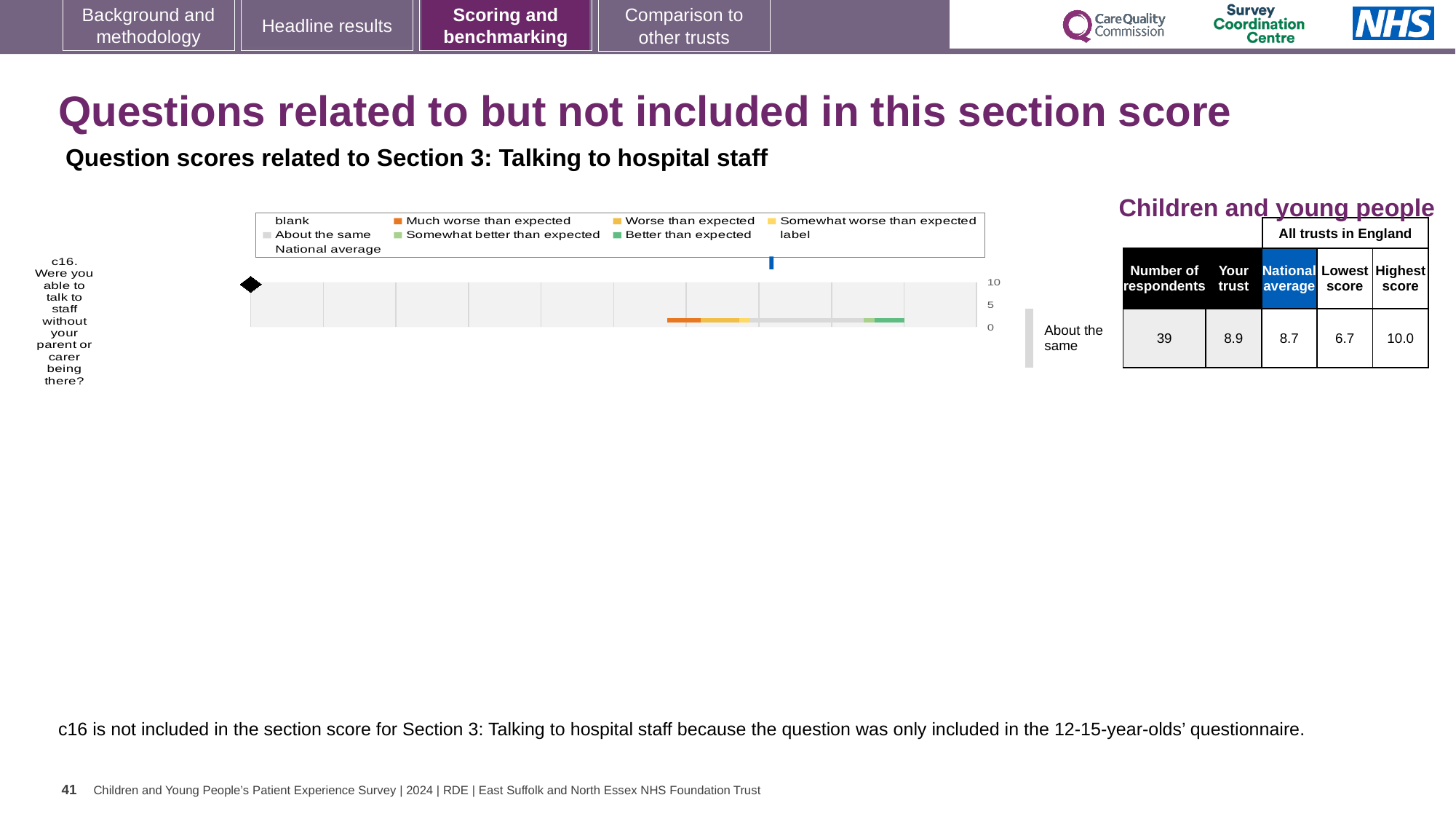
What is the highest score among all trusts in England for c16? 10.0 By how much does the 'Your trust' score for c16 exceed the national average? 0.2 What is the national average score for c16? 8.7 What is the 'Your trust' score for c16? 8.9 What is the lowest score among all trusts in England for c16? 6.7 What is the full wording of question c16 shown on the chart's axis? Were you able to talk to staff without your parent or carer being there? Which benchmark category is the c16 result placed in, according to the label next to the chart? About the same What is the difference between the highest and lowest scores for c16 across all trusts in England? 3.3 How many survey questions are plotted in the chart? 1 How many respondents answered question c16? 39 What kind of chart is shown for question c16? bar chart Which is higher for c16: the 'Your trust' score or the national average? Your trust